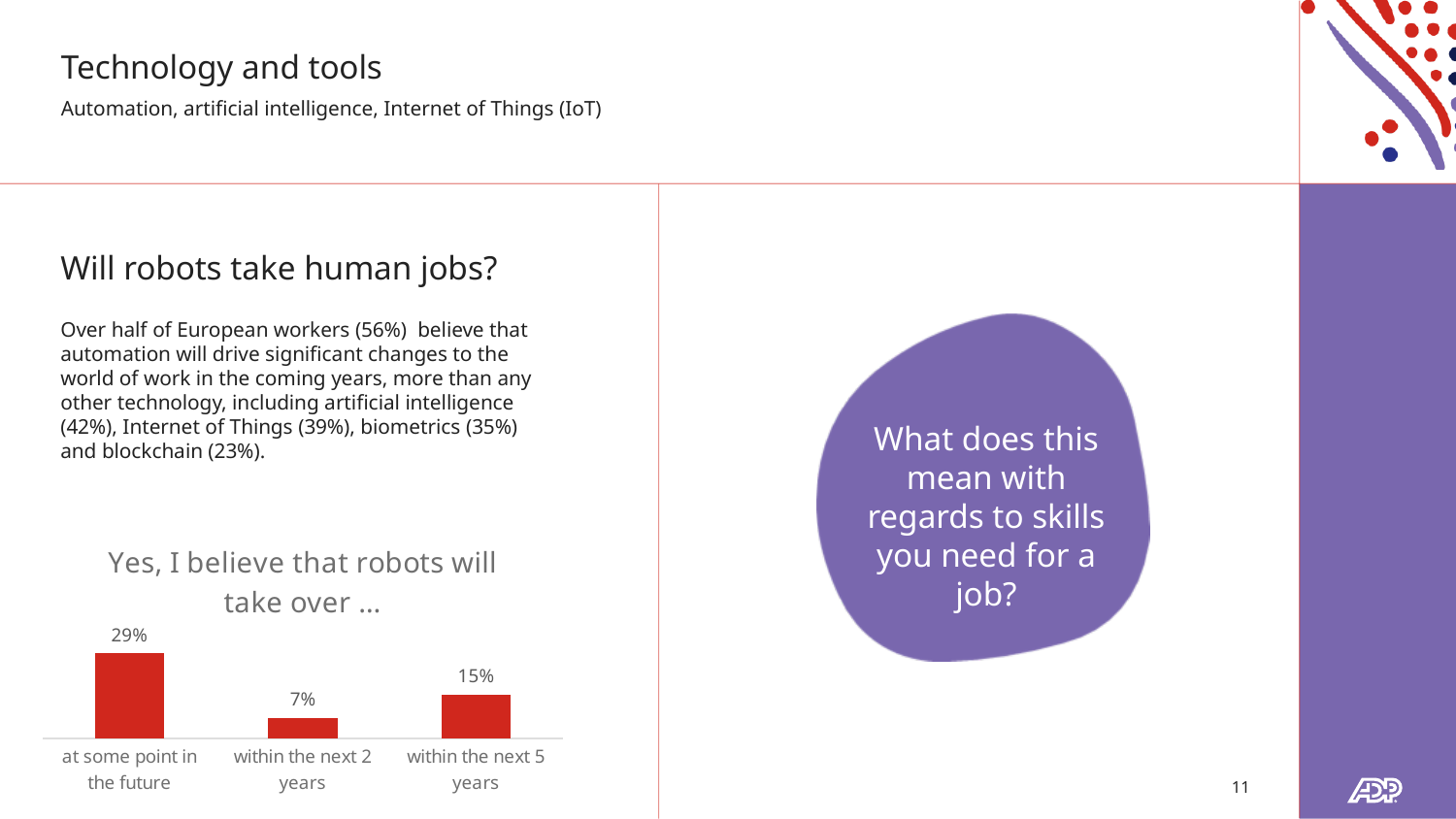
What is the value for 'within the next 2 years'? 7% Which is larger, the value for 'within the next 2 years' or 'within the next 5 years'? within the next 5 years How many categories are shown in the chart? 3 What is the value for 'within the next 5 years'? 15% What kind of chart is shown on the slide? bar chart What is the title of the chart? Yes, I believe that robots will take over … What colour are the bars in the chart? red What is the difference between the values for 'within the next 5 years' and 'within the next 2 years'? 8% Which category has the highest value? at some point in the future What is the value for 'at some point in the future'? 29% Which category has the lowest value? within the next 2 years What is the difference between the values for 'at some point in the future' and 'within the next 5 years'? 14%